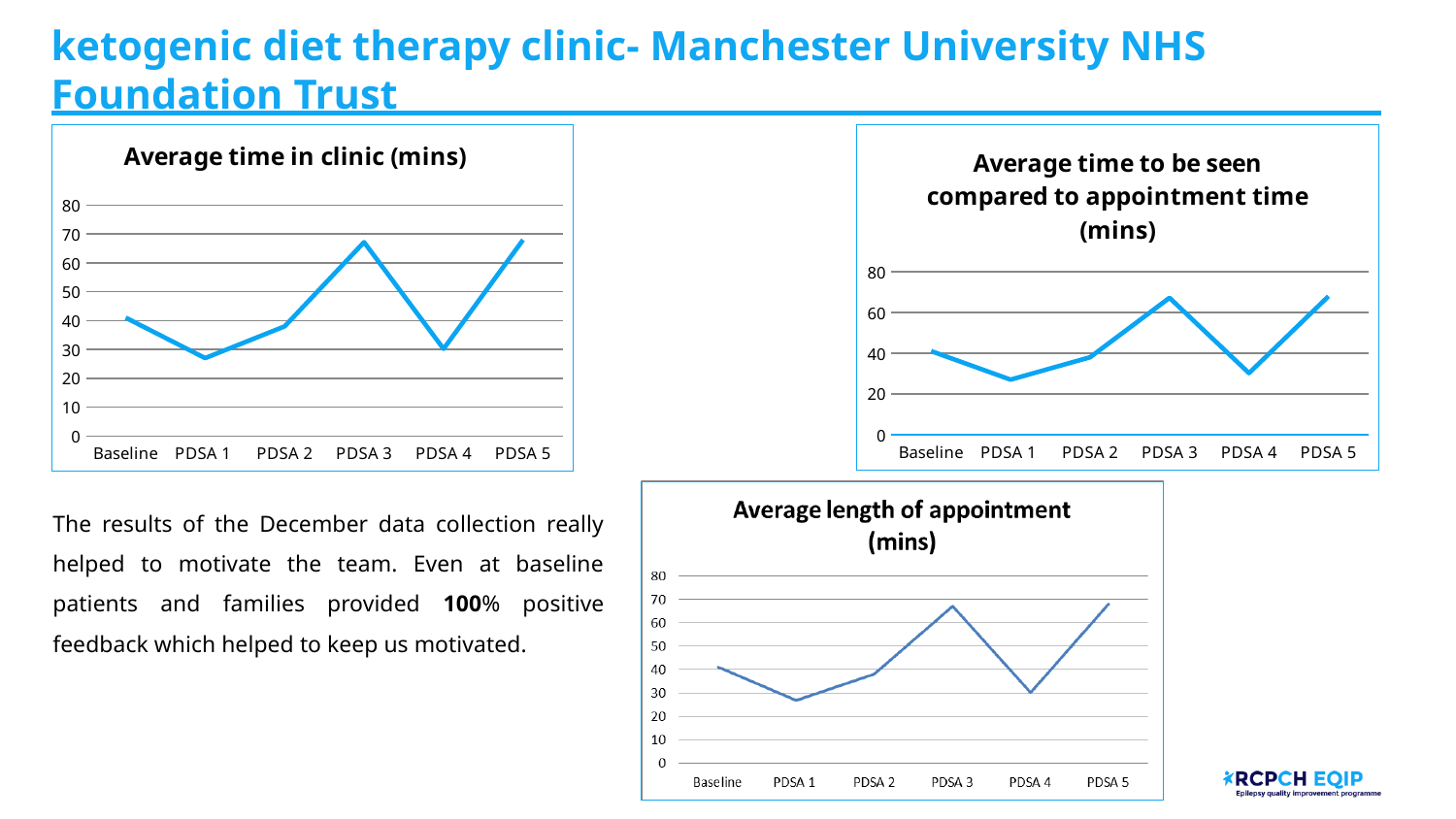
In the 'Average length of appointment (mins)' chart, is the value for PDSA 5 greater or less than 60? greater How many categories are shown on the x axis of the 'Average time in clinic (mins)' chart? 6 In the 'Average length of appointment (mins)' chart, does the value rise or fall from PDSA 1 to PDSA 3? rise In the 'Average time in clinic (mins)' chart, is the value for PDSA 3 greater or less than 60? greater In the 'Average time to be seen compared to appointment time (mins)' chart, is the value for PDSA 4 greater or less than 40? less What is the title of the chart at the bottom centre of the slide? Average length of appointment (mins) In the 'Average time to be seen compared to appointment time (mins)' chart, does the value rise or fall from Baseline to PDSA 1? fall How many charts are shown on the slide? 3 What kind of chart is the 'Average time in clinic (mins)' chart? line chart In the 'Average time to be seen compared to appointment time (mins)' chart, which is larger, the value for PDSA 1 or the value for PDSA 3? PDSA 3 In the 'Average time in clinic (mins)' chart, which is larger, the value for PDSA 3 or the value for PDSA 4? PDSA 3